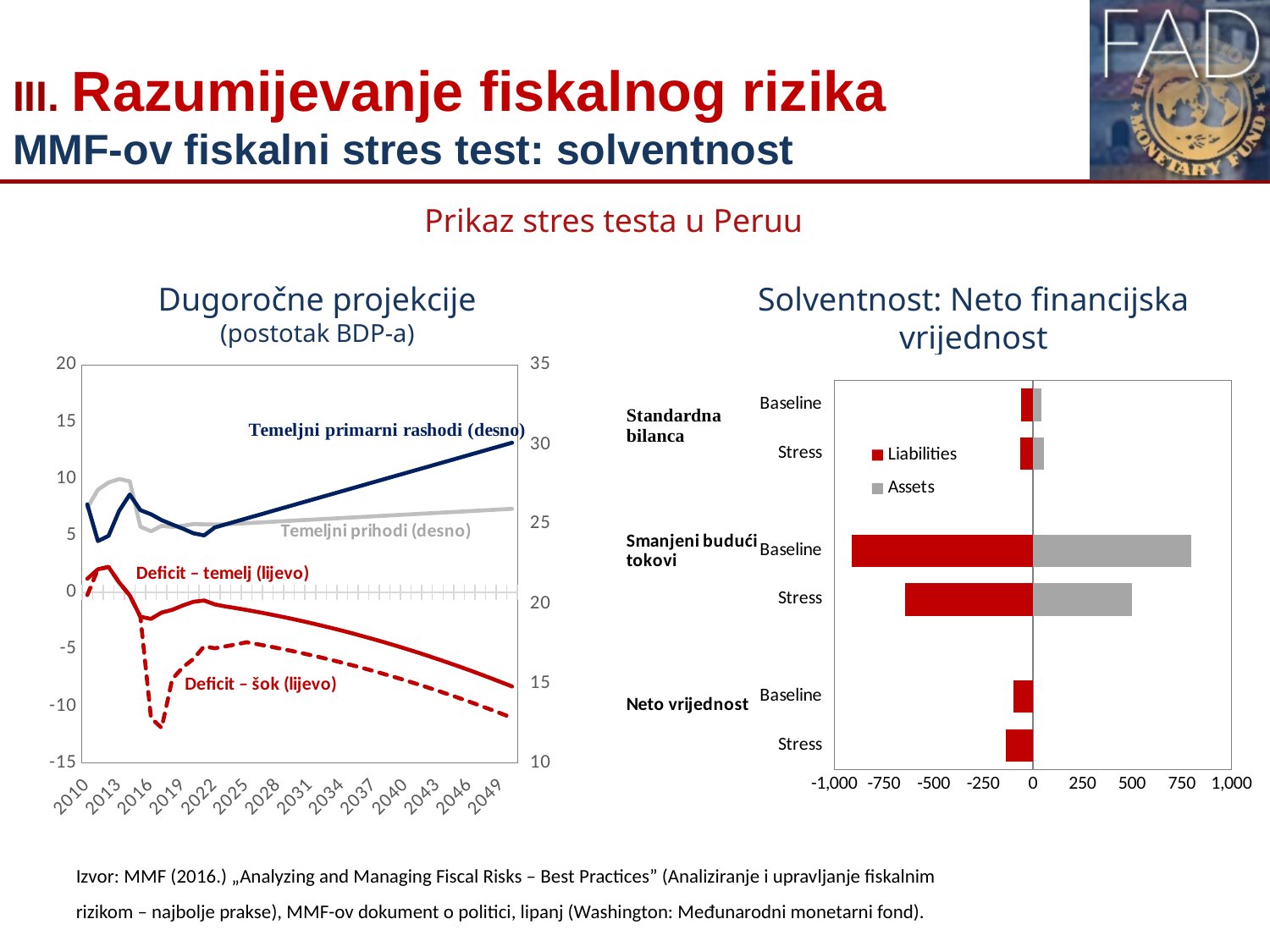
In the right chart "Solventnost: Neto financijska vrijednost", is the Assets value for Smanjeni budući tokovi Stress greater or less than 250? greater What kind of chart is the right chart titled "Solventnost: Neto financijska vrijednost"? bar chart In the right chart "Solventnost: Neto financijska vrijednost", which has the larger Assets bar: Smanjeni budući tokovi Baseline or Smanjeni budući tokovi Stress? Smanjeni budući tokovi Baseline In the right chart "Solventnost: Neto financijska vrijednost", how many category groups are shown on the vertical axis? 3 In the right chart "Solventnost: Neto financijska vrijednost", how many series does the legend list? 2 In the left chart "Dugoročne projekcije", which series is drawn with a dashed line? Deficit – šok (lijevo) In the right chart "Solventnost: Neto financijska vrijednost", is the Liabilities value for Smanjeni budući tokovi Baseline greater or less than -750? less In the right chart "Solventnost: Neto financijska vrijednost", is the Assets value for Smanjeni budući tokovi Baseline greater or less than 500? greater In the left chart "Dugoročne projekcije", does the Deficit – šok (lijevo) line rise or fall from 2025 to 2049? fall In the left chart "Dugoročne projekcije", does the Temeljni primarni rashodi (desno) line rise or fall from 2022 to 2049? rise What kind of chart is the left chart titled "Dugoročne projekcije"? line chart